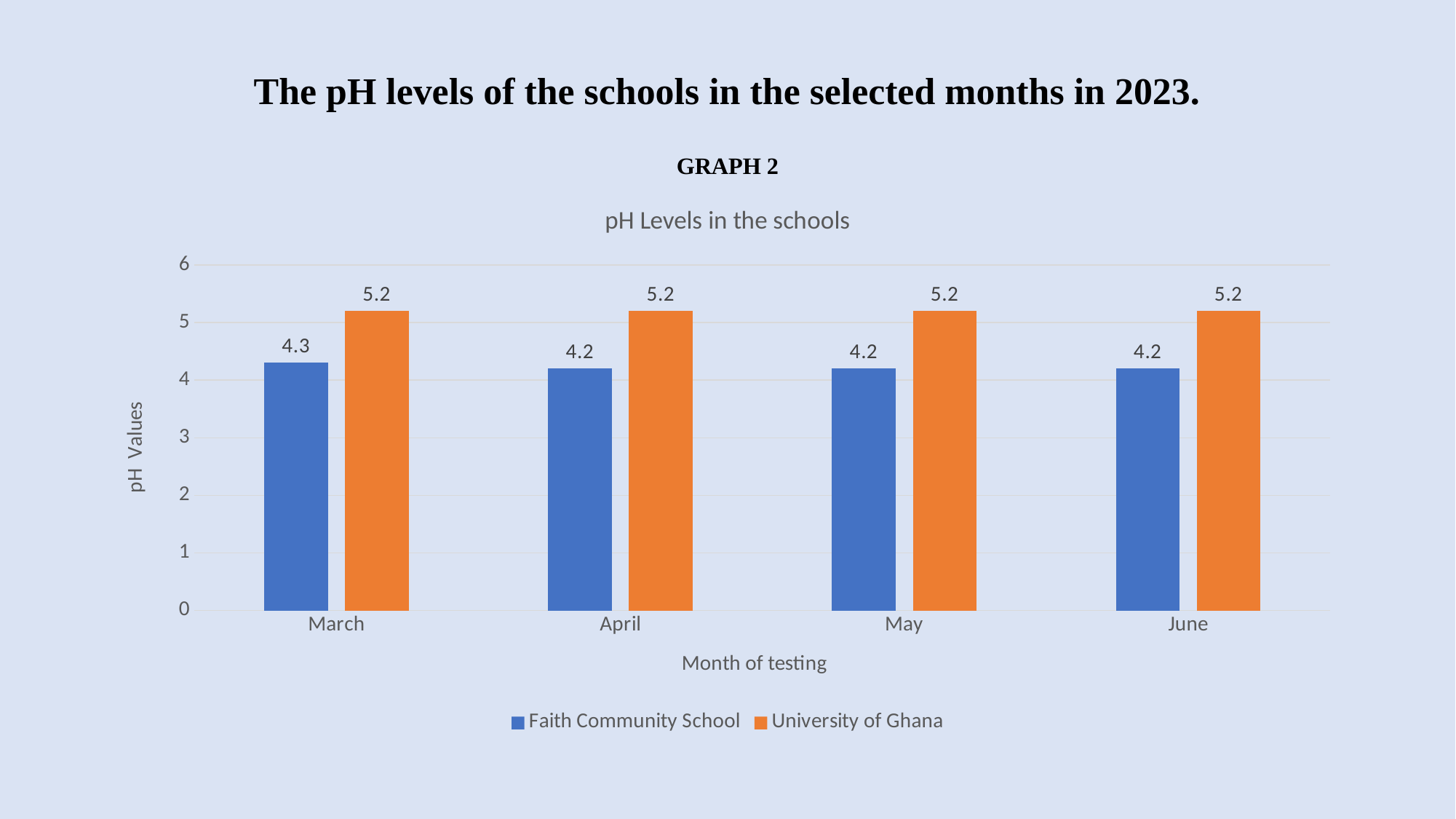
Is the pH value for University of Ghana in June greater or less than 5? greater Which school has the higher pH value in April? University of Ghana What is the title of the chart? pH Levels in the schools How many months are shown on the x axis? 4 In which month is the pH value for Faith Community School highest? March What is the pH value for Faith Community School in June? 4.2 What is the difference between the University of Ghana and Faith Community School pH values in March? 0.9 How many series does the legend list? 2 What is the difference between the University of Ghana and Faith Community School pH values in May? 1.0 What is the pH value for Faith Community School in March? 4.3 What is the pH value for University of Ghana in April? 5.2 What kind of chart is shown? Bar chart